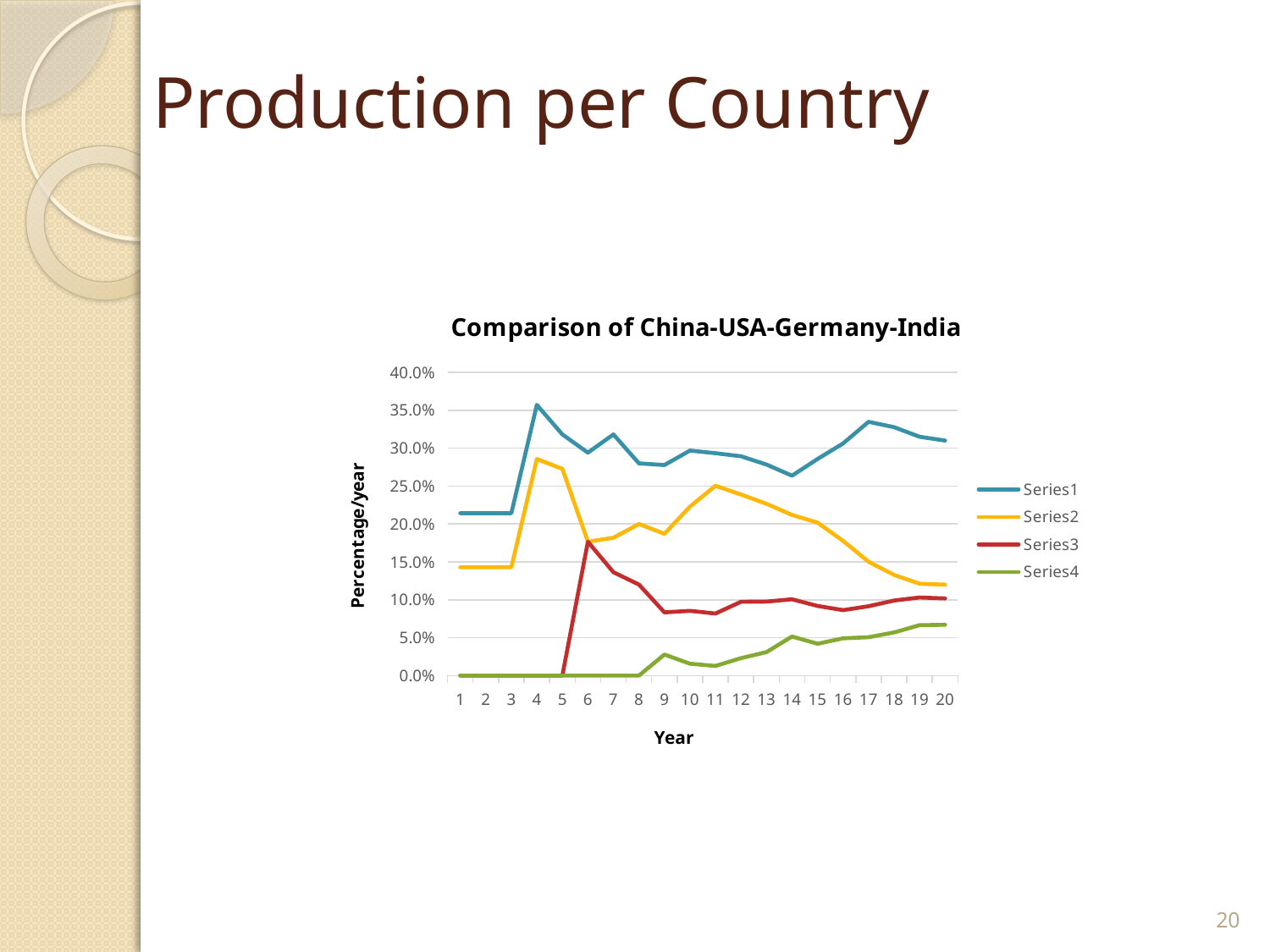
Which series has the highest value at year 20? Series1 Is the value for Series1 at year 1 greater or less than 20.0%? greater Does Series2 rise or fall from year 11 to year 20? fall What kind of chart is shown on the slide? line chart Is the value for Series2 at year 20 greater or less than 10.0%? greater Which series has the lowest value at year 20? Series4 How many series does the legend list? 4 What is the label of the vertical axis? Percentage/year What is the title of the chart? Comparison of China-USA-Germany-India What is the value of Series4 at year 1? 0.0% At year 10, which is larger, Series2 or Series3? Series2 How many years are plotted along the x axis? 20